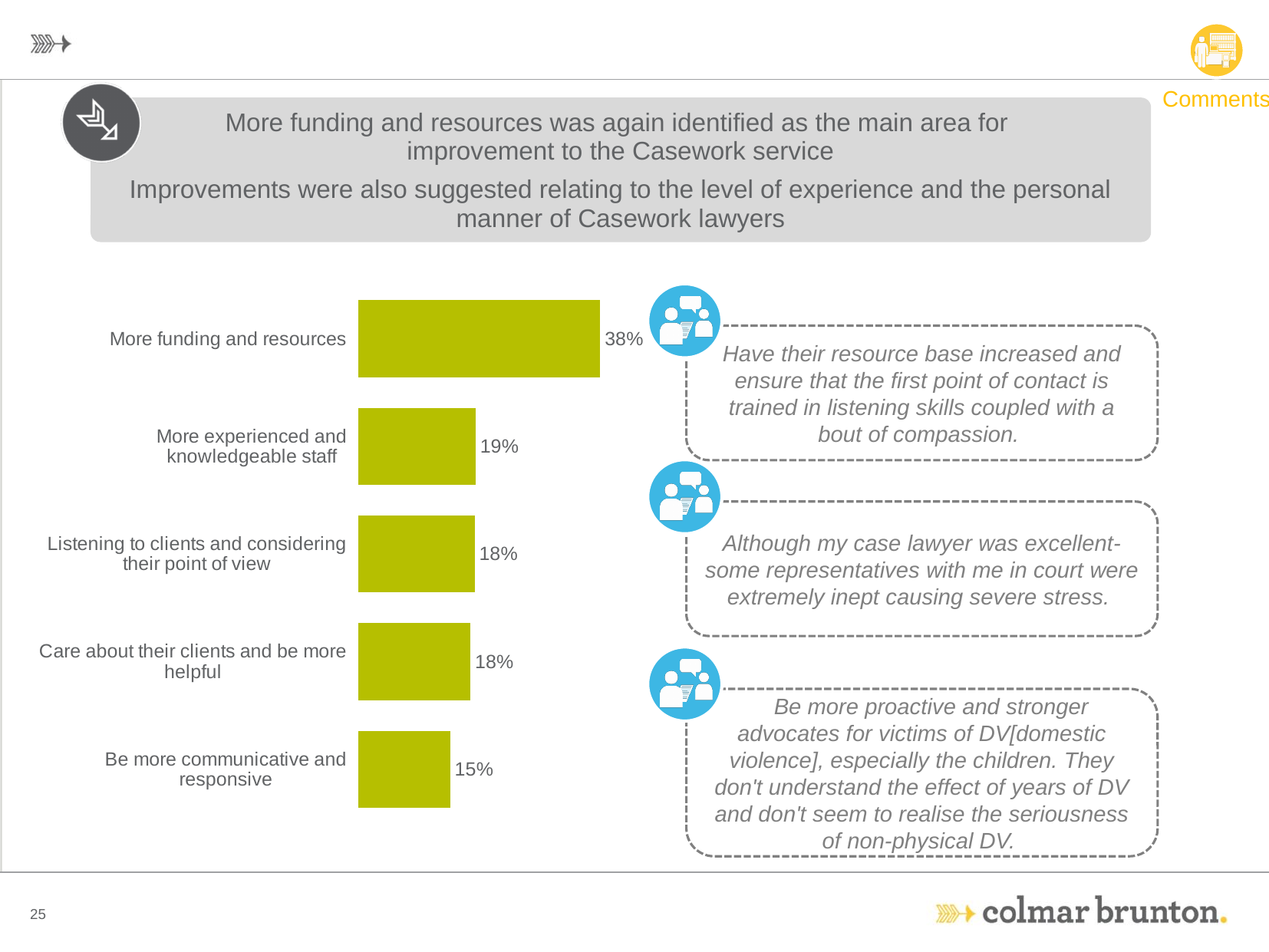
Which category has the highest value? More funding and resources Which is larger: the value for "More experienced and knowledgeable staff" or the value for "Be more communicative and responsive"? More experienced and knowledgeable staff Which category has the lowest value? Be more communicative and responsive What kind of chart is shown on the slide? Bar chart What is the difference between the values for "More funding and resources" and "More experienced and knowledgeable staff"? 19% How many categories are shown in the chart? 5 What is the value for "Care about their clients and be more helpful"? 18% What is the value for "More experienced and knowledgeable staff"? 19% What is the value for "More funding and resources"? 38% What is the difference between the values for "Listening to clients and considering their point of view" and "Be more communicative and responsive"? 3% What colour are the bars in the chart? Yellow-green What is the value for "Be more communicative and responsive"? 15%